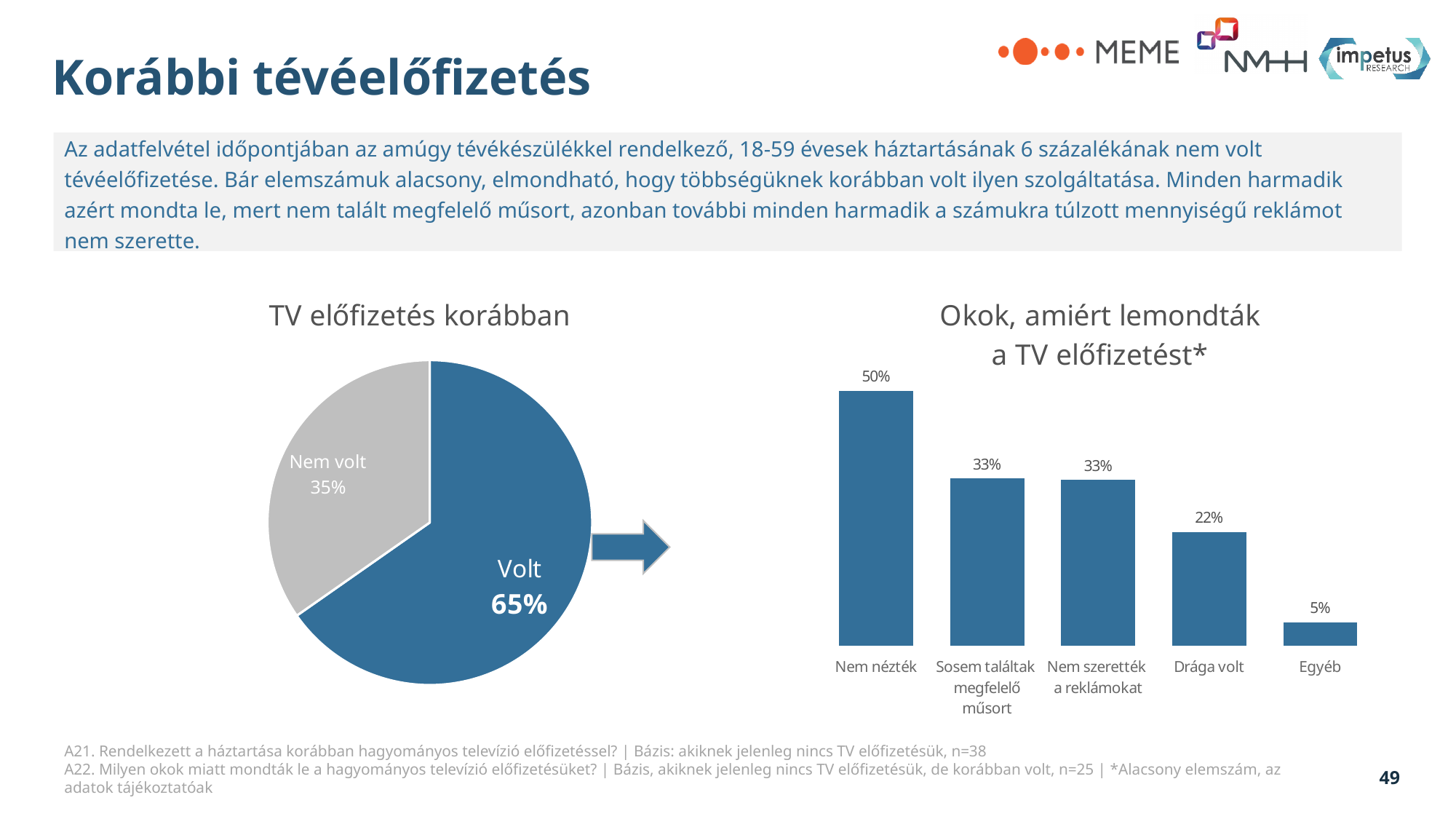
What kind of chart is "TV előfizetés korábban"? Pie chart In the "TV előfizetés korábban" chart, what is the value for "Nem volt"? 35% What kind of chart is "Okok, amiért lemondták a TV előfizetést*"? Bar chart In the "Okok, amiért lemondták a TV előfizetést*" chart, which category has the lowest value? Egyéb In the "Okok, amiért lemondták a TV előfizetést*" chart, what is the value for "Nem nézték"? 50% In the "Okok, amiért lemondták a TV előfizetést*" chart, which category has the highest value? Nem nézték In the "Okok, amiért lemondták a TV előfizetést*" chart, what is the value for "Drága volt"? 22% How many categories are shown in the "Okok, amiért lemondták a TV előfizetést*" chart? 5 In the "TV előfizetés korábban" chart, how many slices does the pie have? 2 In the "TV előfizetés korábban" chart, which slice is larger, "Volt" or "Nem volt"? Volt In the "TV előfizetés korábban" chart, what is the value for "Volt"? 65% In the "Okok, amiért lemondták a TV előfizetést*" chart, what is the difference between "Nem nézték" and "Drága volt"? 28%